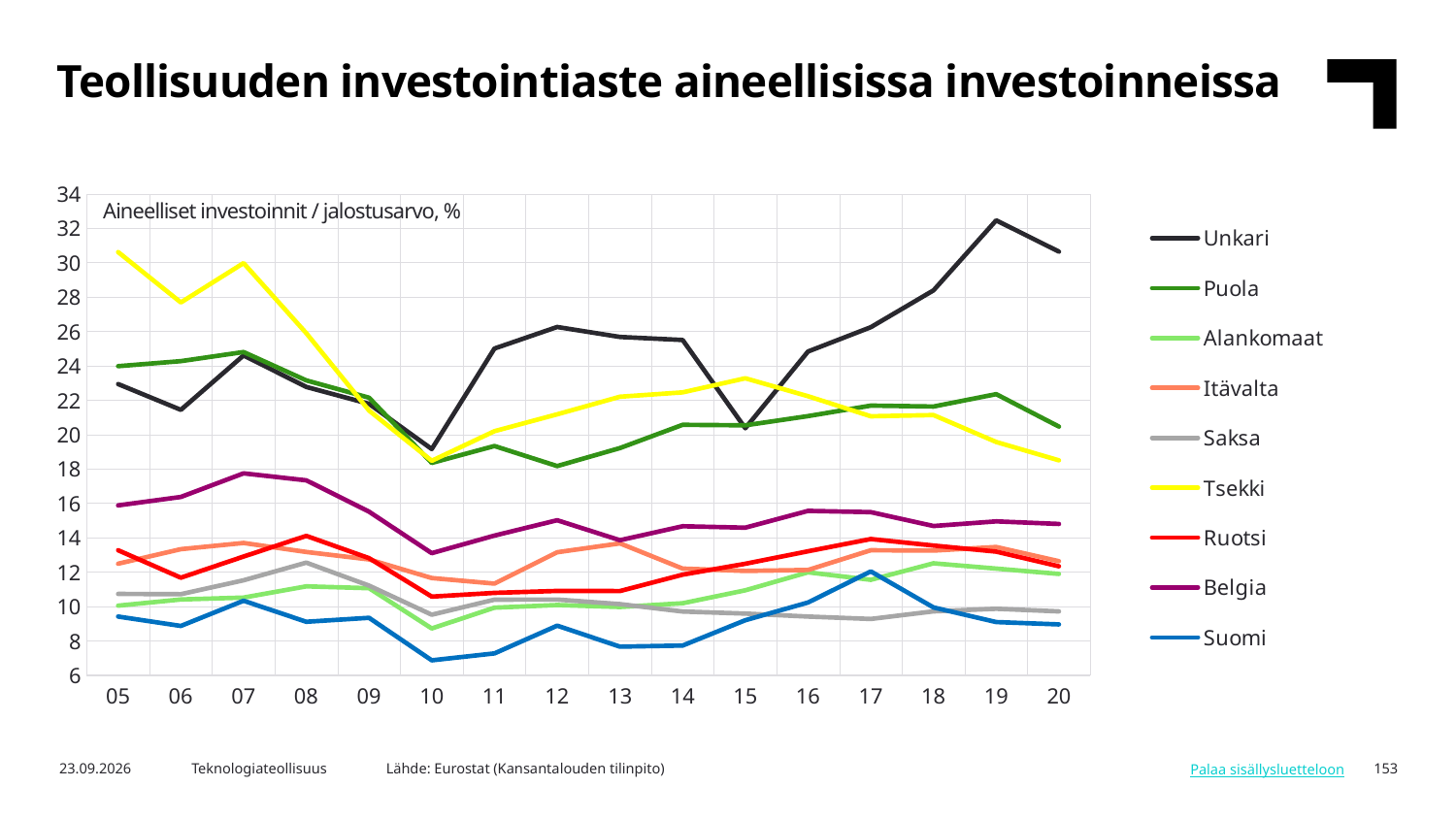
Which series has the lowest value in 10? Suomi Is the value for Unkari in 19 greater or less than 30? greater In 17, which is higher: Puola or Alankomaat? Puola Does the Unkari line rise or fall from 15 to 19? rises Which series has the highest value in 20? Unkari How many years are shown along the x axis? 16 How many series does the legend list? 9 What label is printed inside the plot area at the top left? Aineelliset investoinnit / jalostusarvo, % What kind of chart is shown on the slide? line chart Is the value for Tsekki in 20 greater or less than 20? less In 05, which is higher: Tsekki or Unkari? Tsekki Is the value for Suomi in 10 greater or less than 8? less